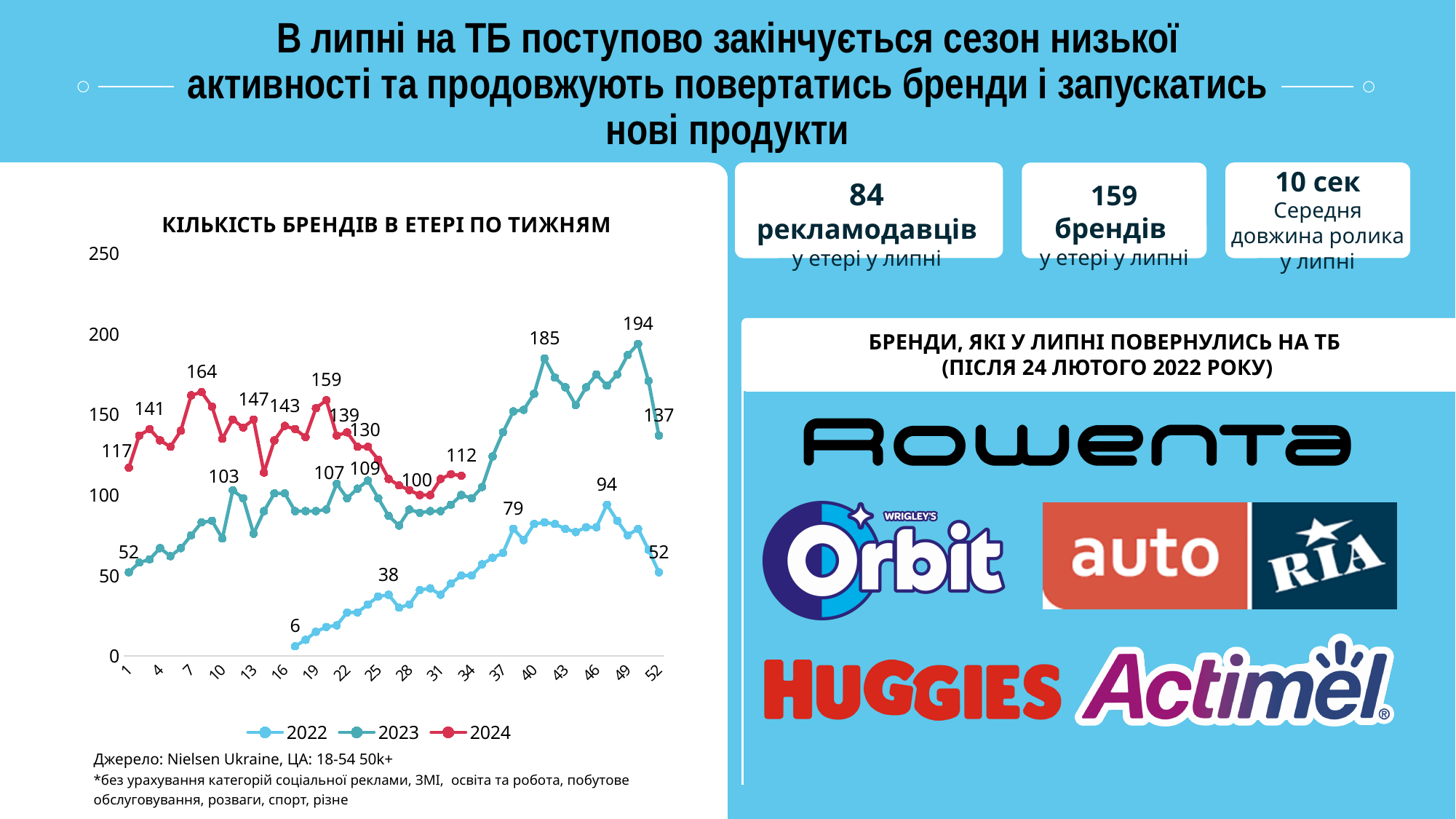
What kind of chart is shown on the slide? line chart What is the title of the chart? КІЛЬКІСТЬ БРЕНДІВ В ЕТЕРІ ПО ТИЖНЯМ What is the value of the 2024 series at week 1? 117 How many series does the chart legend list? 3 What is the difference between the two highest labelled values of the 2023 series, 194 and 185? 9 Which years are listed in the chart legend? 2022, 2023, 2024 What is the value of the 2023 series at week 52? 137 What is the difference between the 2022 series' peak of 94 and its first labelled value of 6? 88 What is the highest labelled value of the 2024 series? 164 At week 1, which series has the larger value, 2023 or 2024? 2024 Which series reaches the highest value on the chart? 2023 Is the value of the 2022 series at week 19 greater or less than 50? less